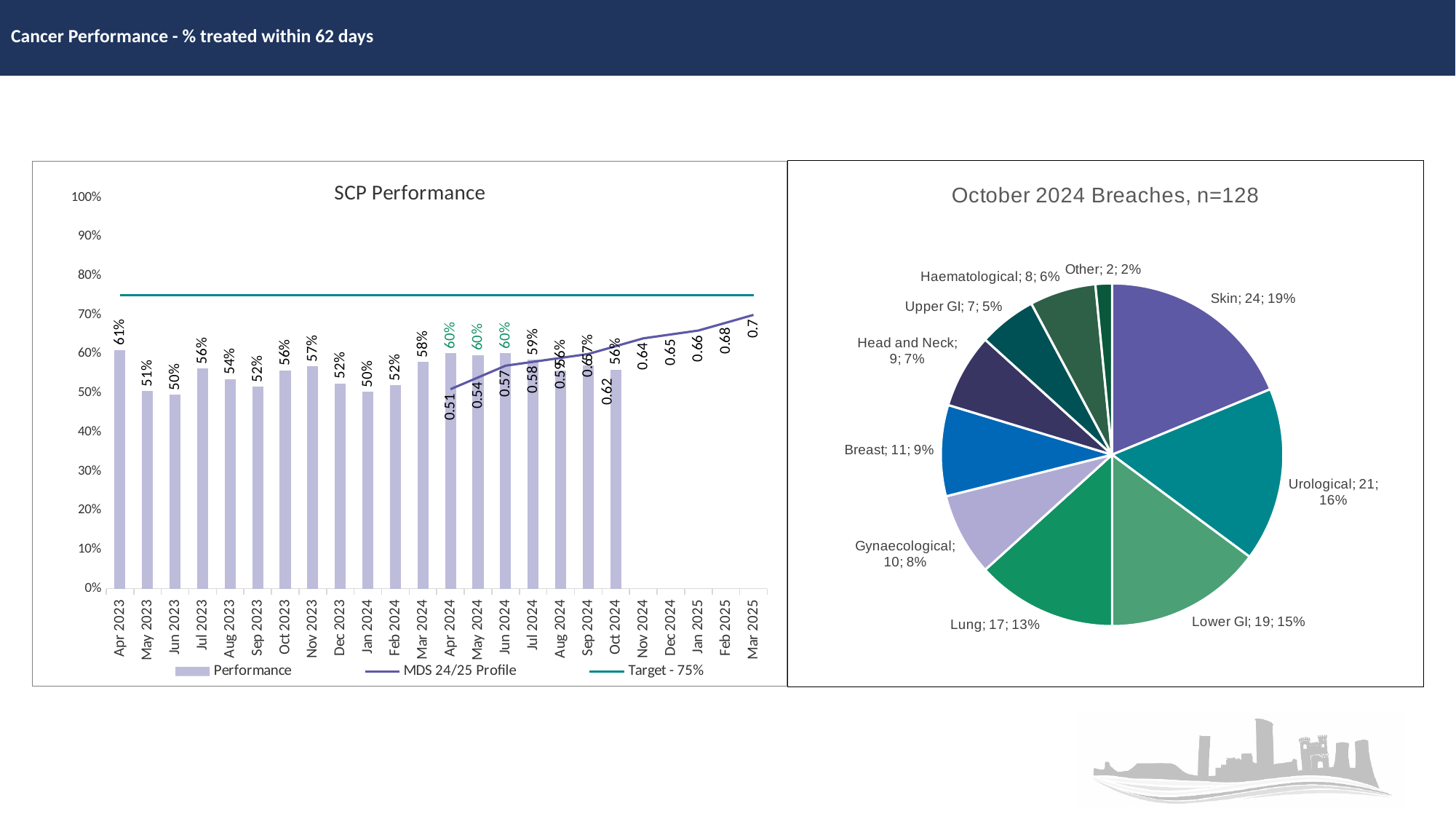
In the SCP Performance chart, is the Performance value for Nov 2023 greater or less than 60%? less In the October 2024 Breaches chart, what share of the pie is Lung? 13% In the SCP Performance chart, what is the Performance value for Apr 2023? 61% In the SCP Performance chart, what is the difference between the Performance values for Apr 2023 and May 2023? 10 percentage points In the SCP Performance chart, what is the MDS 24/25 Profile value for Mar 2025? 0.7 In the SCP Performance chart, what is the Performance value for Mar 2024? 58% In the October 2024 Breaches chart, how many breaches are Urological? 21 In the October 2024 Breaches chart, which category has the smallest slice? Other What kind of chart is the October 2024 Breaches chart? pie chart In the October 2024 Breaches chart, which category has the largest slice? Skin How many series does the legend of the SCP Performance chart list? 3 In the SCP Performance chart, which month has the highest Performance bar? Apr 2023